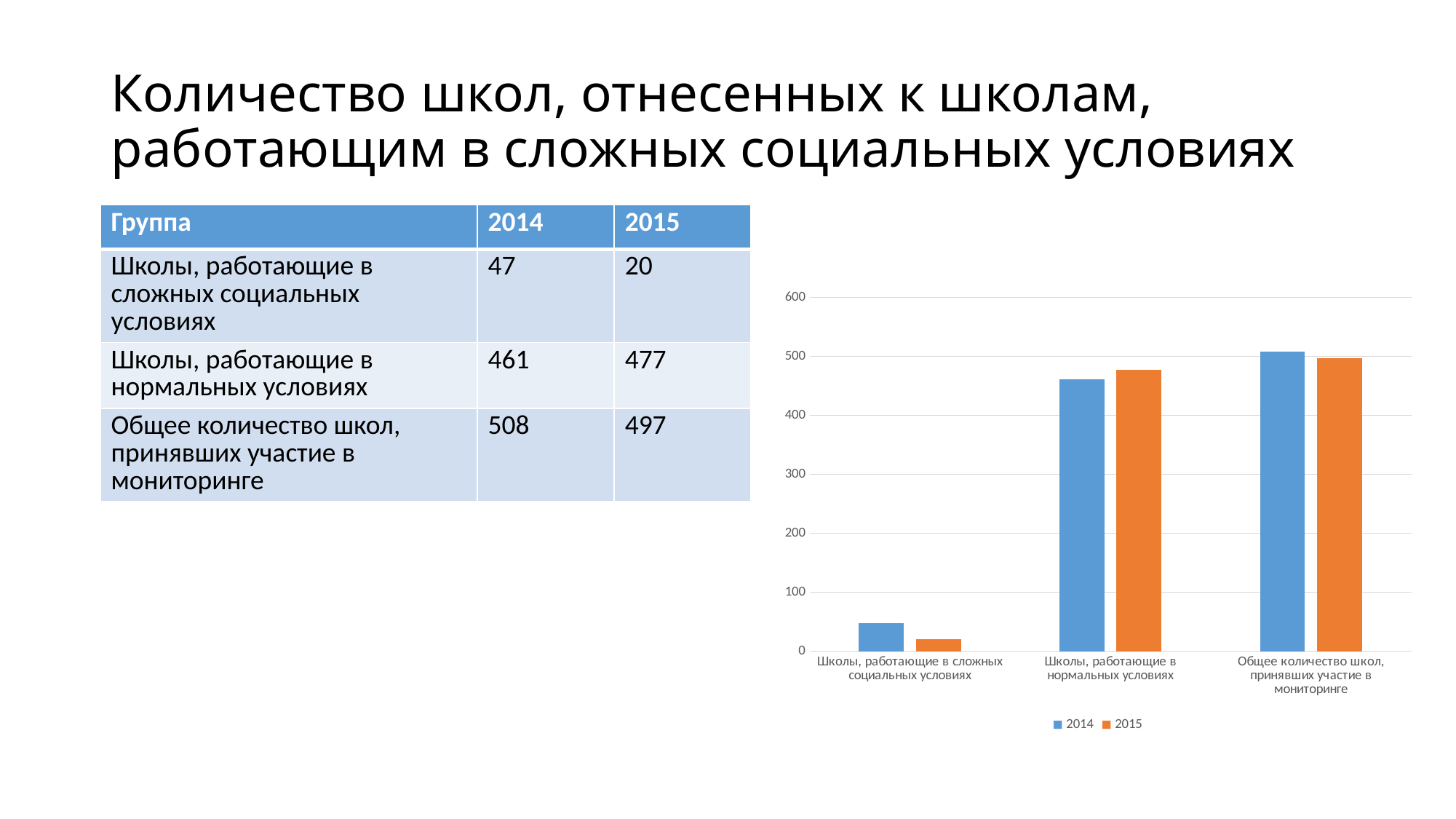
According to the slide, what is the difference between the 2014 and 2015 values for 'Общее количество школ, принявших участие в мониторинге'? 11 Is the 2015 value for 'Школы, работающие в сложных социальных условиях' greater or less than 100? less For 'Школы, работающие в нормальных условиях', which year has the larger value, 2014 or 2015? 2015 How many series does the chart legend list? 2 What kind of chart is shown on the slide? bar chart Which series is shown in orange in the chart? 2015 Is the 2014 value for 'Школы, работающие в нормальных условиях' greater or less than 400? greater Which category has the highest 2014 bar in the chart? Общее количество школ, принявших участие в мониторинге Which category has the lowest bars in the chart? Школы, работающие в сложных социальных условиях For 'Школы, работающие в сложных социальных условиях', which year has the larger value, 2014 or 2015? 2014 How many categories are shown on the x axis of the chart? 3 According to the slide, what is the 2014 value for 'Школы, работающие в сложных социальных условиях'? 47